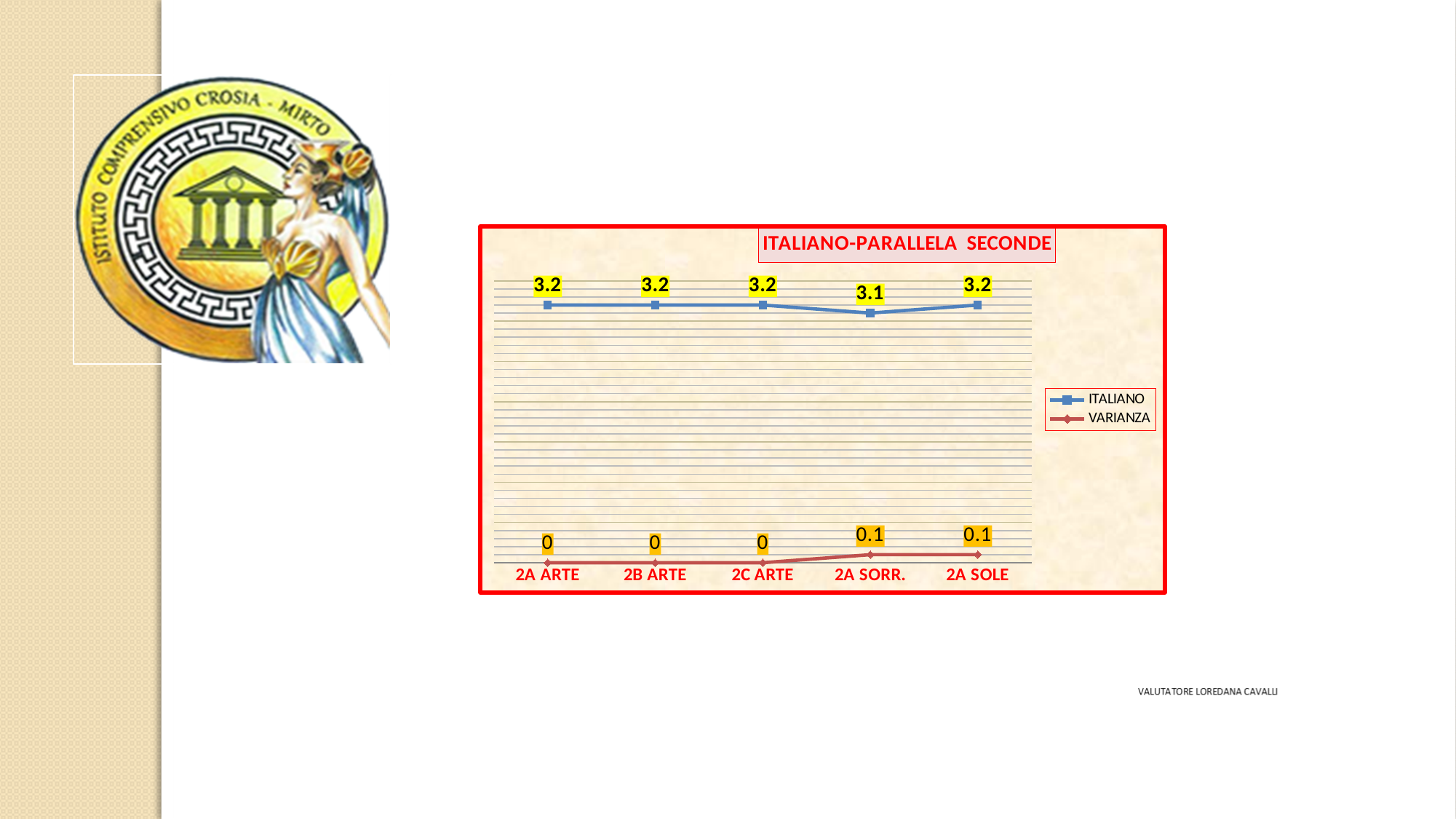
How many categories are shown on the x axis? 5 Which series is drawn in red? VARIANZA What is the title of the chart? ITALIANO-PARALLELA SECONDE Which category has the lowest ITALIANO value? 2A SORR. What is the VARIANZA value for 2C ARTE? 0 What is the ITALIANO value for 2A SORR.? 3.1 Which is larger, the VARIANZA value for 2A SORR. or for 2B ARTE? 2A SORR. What kind of chart is shown? line chart What is the VARIANZA value for 2A SOLE? 0.1 What is the difference between the ITALIANO values for 2A ARTE and 2A SORR.? 0.1 How many series does the legend list? 2 What is the ITALIANO value for 2B ARTE? 3.2